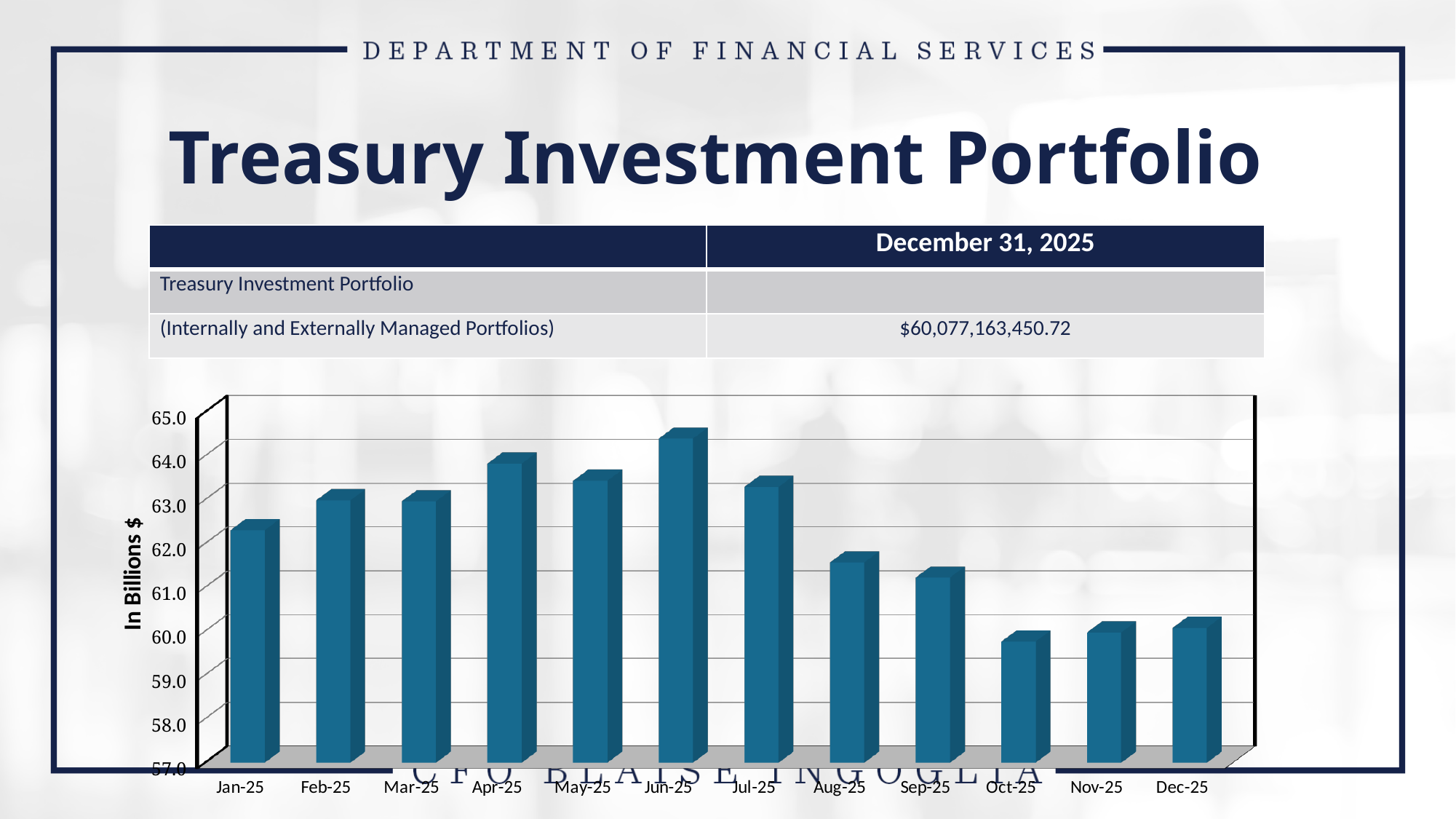
What is the label on the vertical axis of the chart? In Billions $ Is the value for Jan-25 greater or less than 63.0? less Which is larger, the value for Jun-25 or the value for Dec-25? Jun-25 Which month has the highest bar in the chart? Jun-25 What kind of chart is shown on the slide? bar chart How many months are plotted on the x axis of the chart? 12 Is the value for Jun-25 greater or less than 64.0? greater Is the value for Apr-25 greater or less than 63.0? greater Do the values rise or fall from Jun-25 to Oct-25? fall Which is larger, the value for Apr-25 or the value for Aug-25? Apr-25